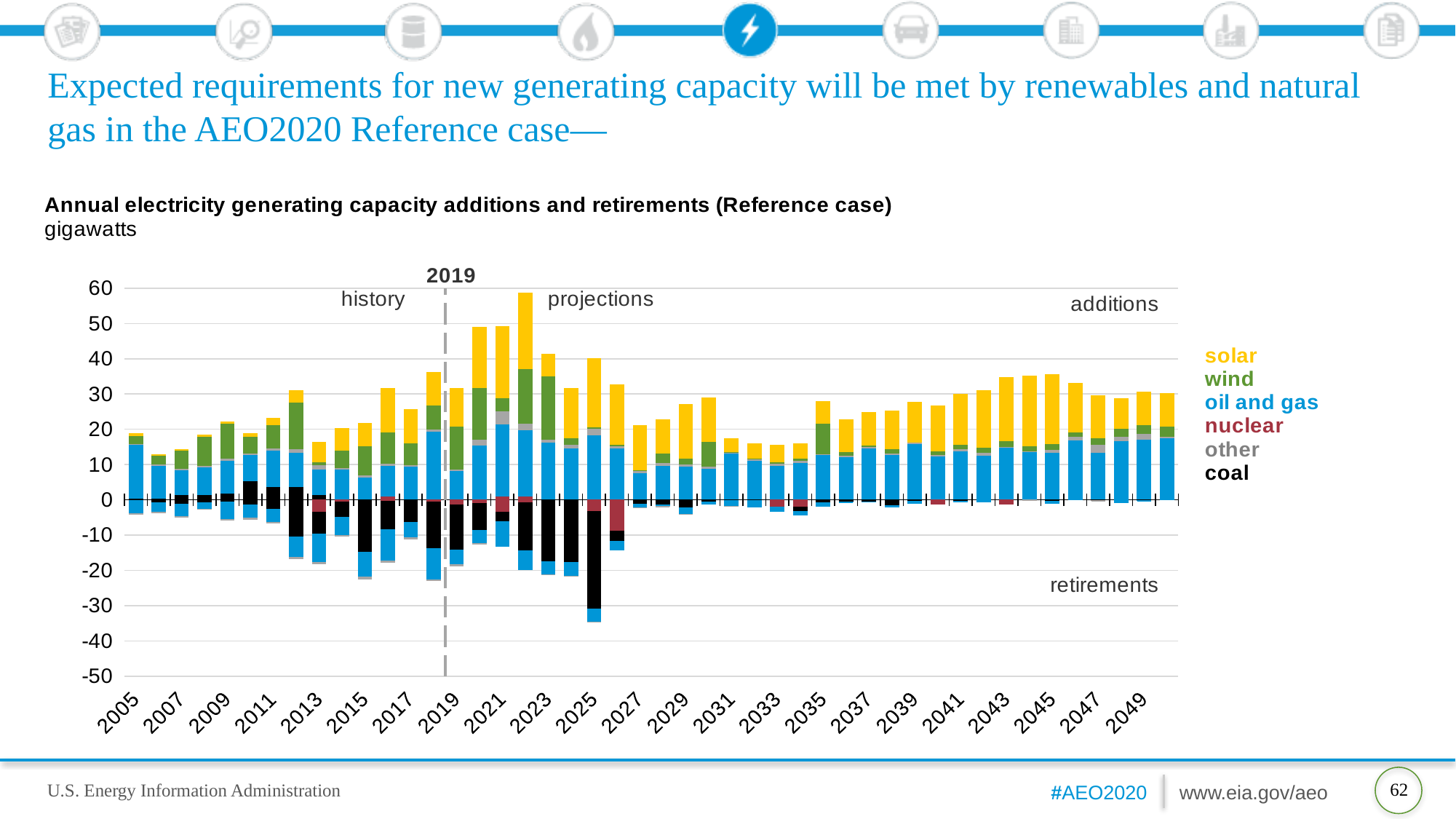
Which year does the dashed vertical line separating history from projections mark? 2019 Which year has larger total additions, 2020 or 2028? 2020 What unit is the y axis measured in? gigawatts Are the total retirements in 2025 greater or less than -30 gigawatts? less Are the total additions in 2032 greater or less than 20 gigawatts? less Are the total additions in 2022 greater or less than 50 gigawatts? greater What is the title of the chart? Annual electricity generating capacity additions and retirements (Reference case) Which year has the highest total capacity additions? 2022 What kind of chart is shown on the slide? stacked bar chart How many series does the legend list? 6 Which year has the largest total capacity retirements? 2025